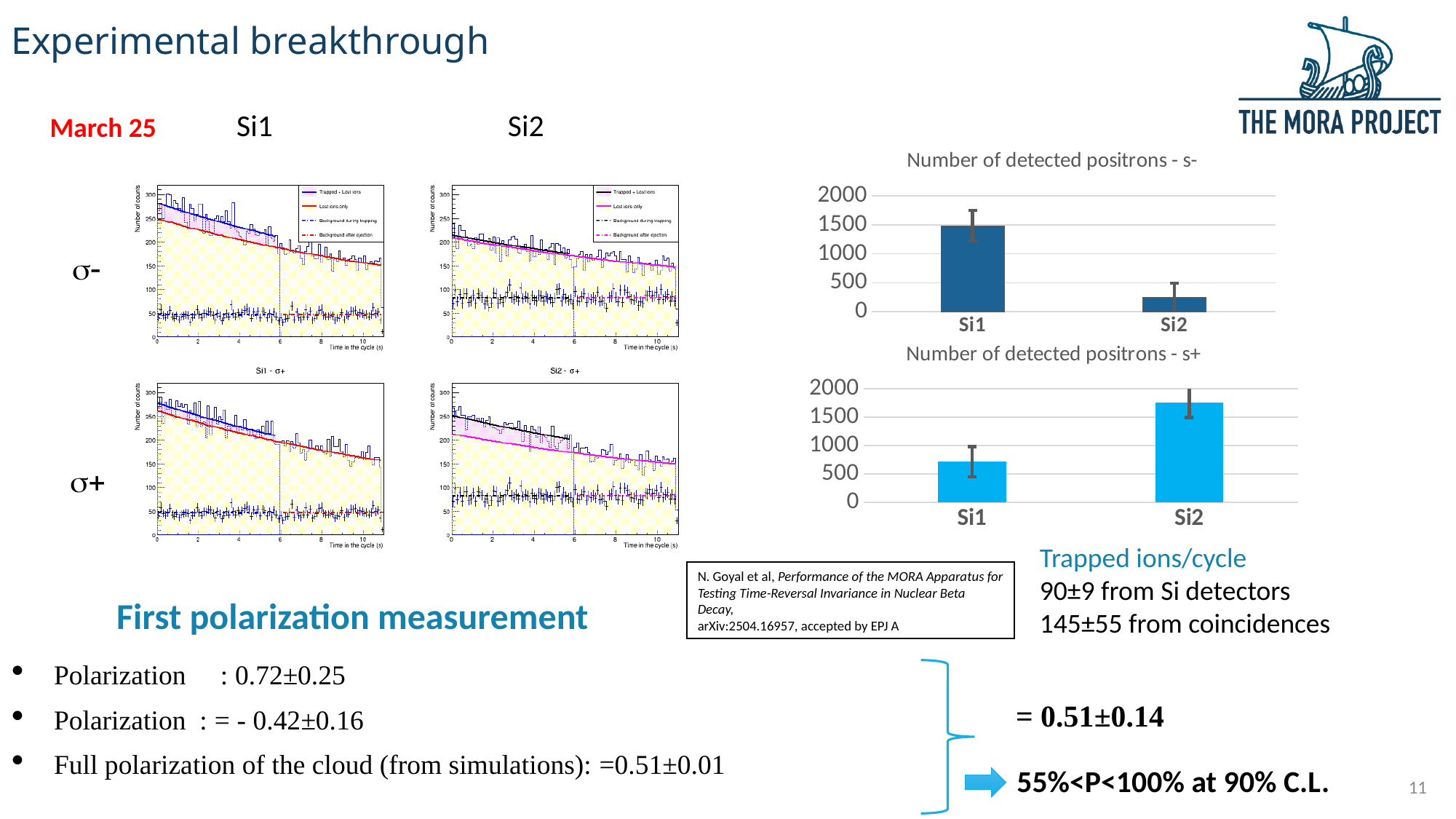
In the chart titled 'Number of detected positrons - s+', which category has the higher bar? Si2 How many categories are shown on the x axis of the chart titled 'Number of detected positrons - s-'? 2 In the chart titled 'Number of detected positrons - s-', is the value for Si2 greater or less than 500? less What is the title of the upper bar chart on the right side of the slide? Number of detected positrons - s- In the chart titled 'Number of detected positrons - s+', is the value for Si2 greater or less than 1500? greater In the chart titled 'Number of detected positrons - s-', is the value for Si1 greater or less than 1000? greater In the chart titled 'Number of detected positrons - s-', which category has the lower bar? Si2 In the chart titled 'Number of detected positrons - s-', which category has the higher bar? Si1 What kind of chart is the chart titled 'Number of detected positrons - s+'? bar chart In the chart titled 'Number of detected positrons - s+', which category has the lower bar? Si1 In the chart titled 'Number of detected positrons - s+', is the value for Si1 larger or smaller than the value for Si2? smaller